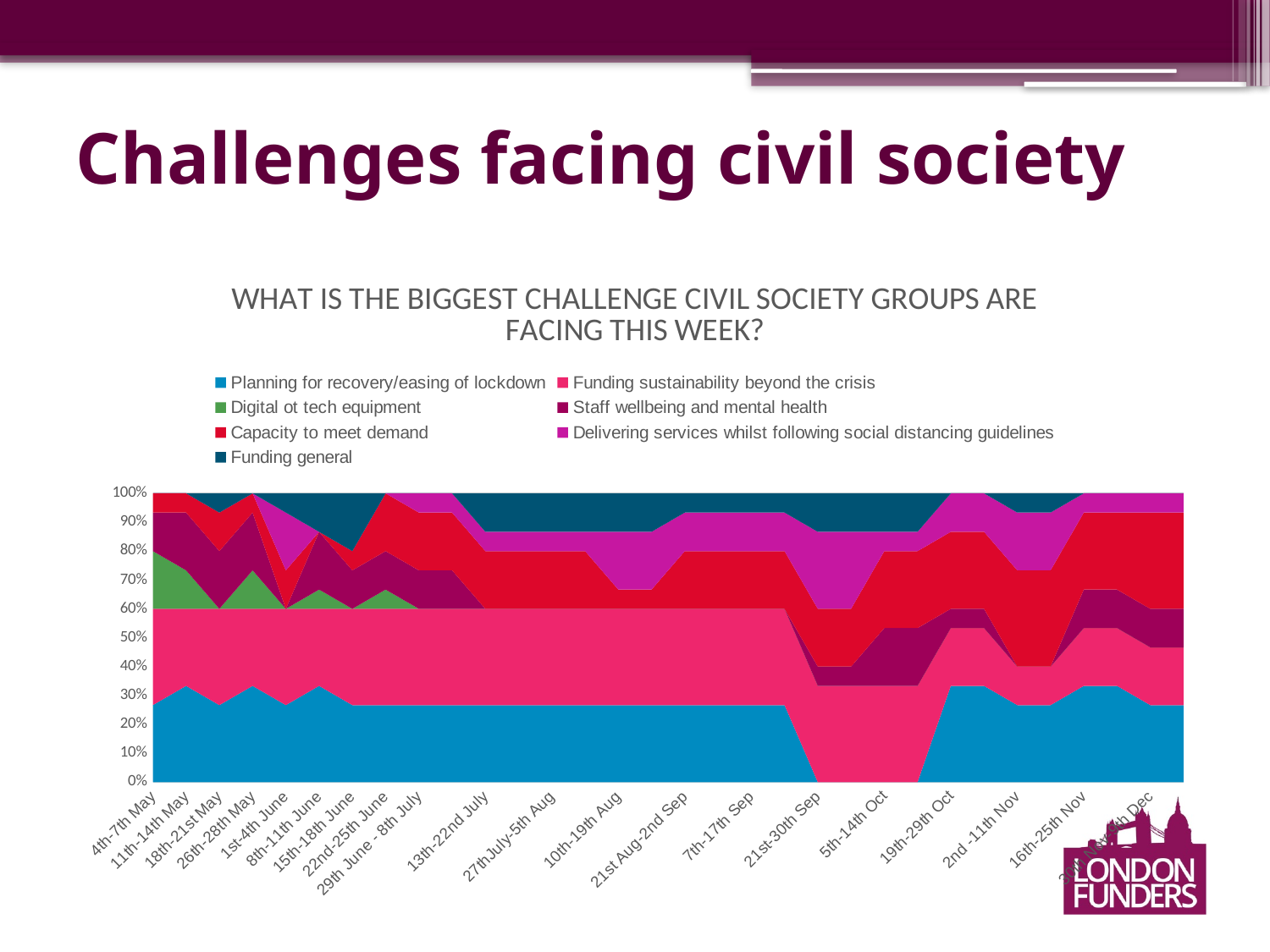
Is the share for 'Planning for recovery/easing of lockdown' in the 13th-22nd July period greater or less than 30%? less Is the share for 'Funding sustainability beyond the crisis' in the 13th-22nd July period greater or less than 30%? greater Does the share for 'Planning for recovery/easing of lockdown' rise or fall from the 7th-17th Sep period to the 21st-30th Sep period? Fall Is the share for 'Digital ot tech equipment' in the 4th-7th May period greater or less than 30%? less In the 4th-7th May period, which has the larger share: 'Funding sustainability beyond the crisis' or 'Digital ot tech equipment'? Funding sustainability beyond the crisis How many series does the legend list? 7 What is the value for 'Planning for recovery/easing of lockdown' in the 5th-14th Oct period? 0% What is the value for 'Planning for recovery/easing of lockdown' in the 21st-30th Sep period? 0% Which colour represents 'Planning for recovery/easing of lockdown' in the legend? Blue What kind of chart is shown on the slide? Stacked area chart Which series has the largest share in the 13th-22nd July period? Funding sustainability beyond the crisis What is the title of the chart? WHAT IS THE BIGGEST CHALLENGE CIVIL SOCIETY GROUPS ARE FACING THIS WEEK?